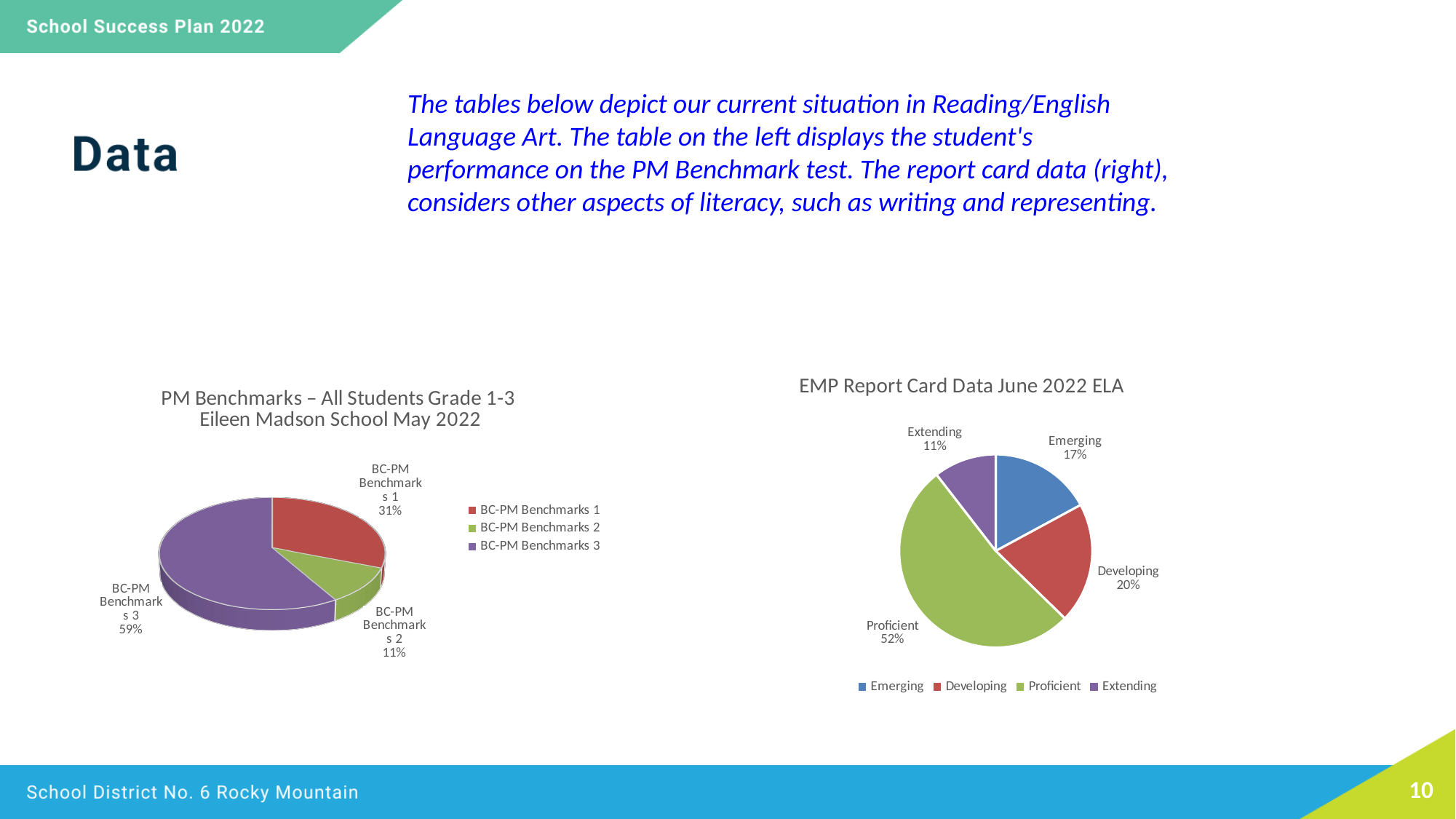
In the EMP Report Card Data chart on the right, what percentage of students are Proficient? 52% In the PM Benchmarks chart on the left, what share of students is in BC-PM Benchmarks 3? 59% In the PM Benchmarks chart on the left, which category has the smallest share? BC-PM Benchmarks 2 What type of chart is the EMP Report Card Data chart on the right? Pie chart In the PM Benchmarks chart on the left, what is the difference in percentage points between BC-PM Benchmarks 3 and BC-PM Benchmarks 1? 28 In the PM Benchmarks chart on the left, which category has the largest share? BC-PM Benchmarks 3 In the EMP Report Card Data chart on the right, which category has the smallest share? Extending In the EMP Report Card Data chart on the right, which is larger, Developing or Emerging? Developing In the PM Benchmarks chart on the left, what share of students is in BC-PM Benchmarks 1? 31% In the PM Benchmarks chart on the left, how many categories are shown? 3 In the EMP Report Card Data chart on the right, how many categories does the legend list? 4 In the EMP Report Card Data chart on the right, what percentage of students are Emerging? 17%